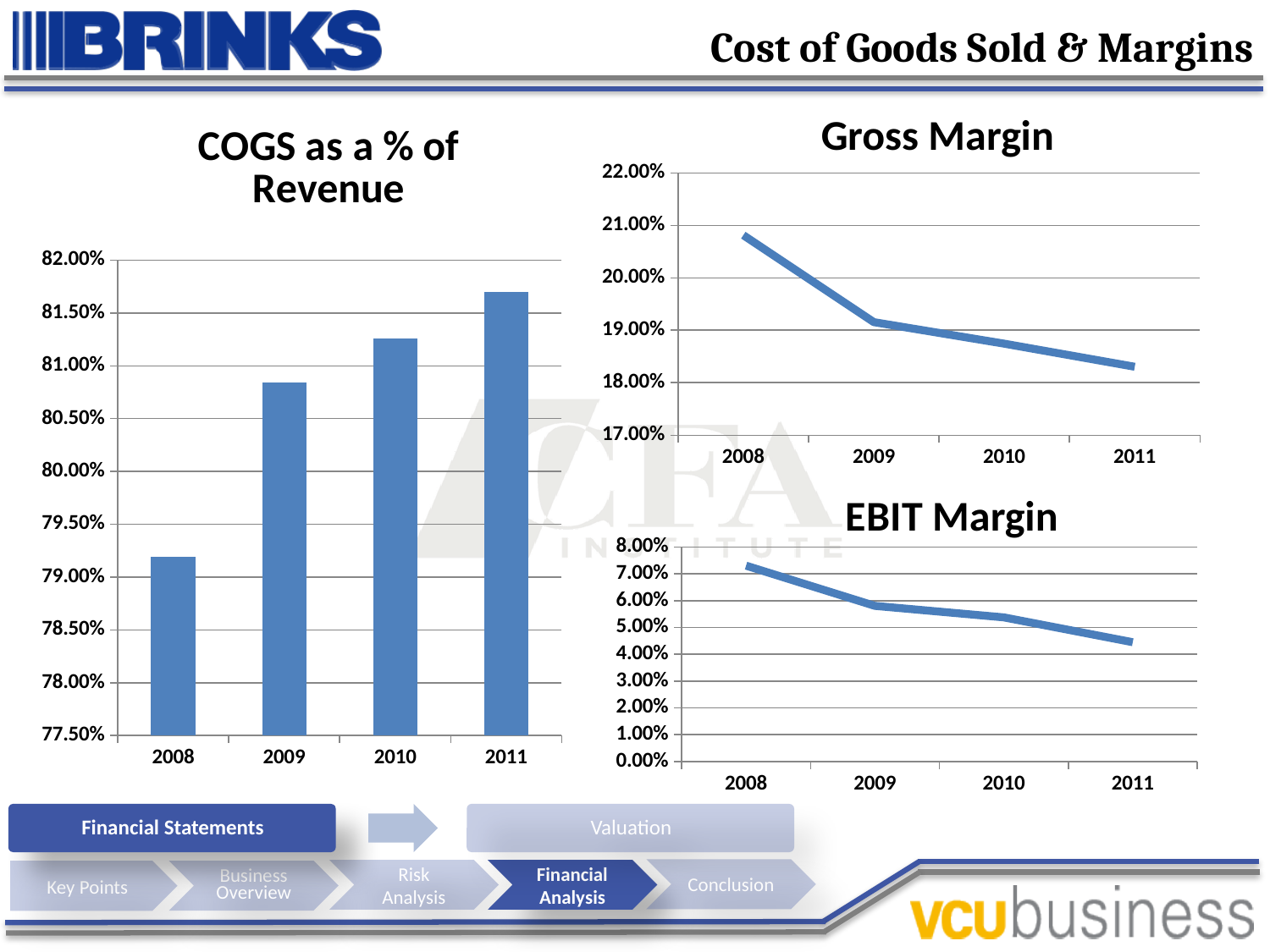
How many years are shown on the x axis of the 'EBIT Margin' chart? 4 In the 'COGS as a % of Revenue' chart, which year has the lowest value? 2008 In the 'EBIT Margin' chart, do the values rise or fall from 2008 to 2011? fall In the 'Gross Margin' chart, is the value for 2008 greater or less than 20.00%? greater In the 'COGS as a % of Revenue' chart, is the value for 2008 greater or less than 79.50%? less In the 'Gross Margin' chart, is the value for 2011 greater or less than 19.00%? less What kind of chart is the 'COGS as a % of Revenue' chart? bar chart In the 'Gross Margin' chart, which year has the highest value? 2008 In the 'COGS as a % of Revenue' chart, which year has the highest value? 2011 What kind of chart is the 'Gross Margin' chart? line chart